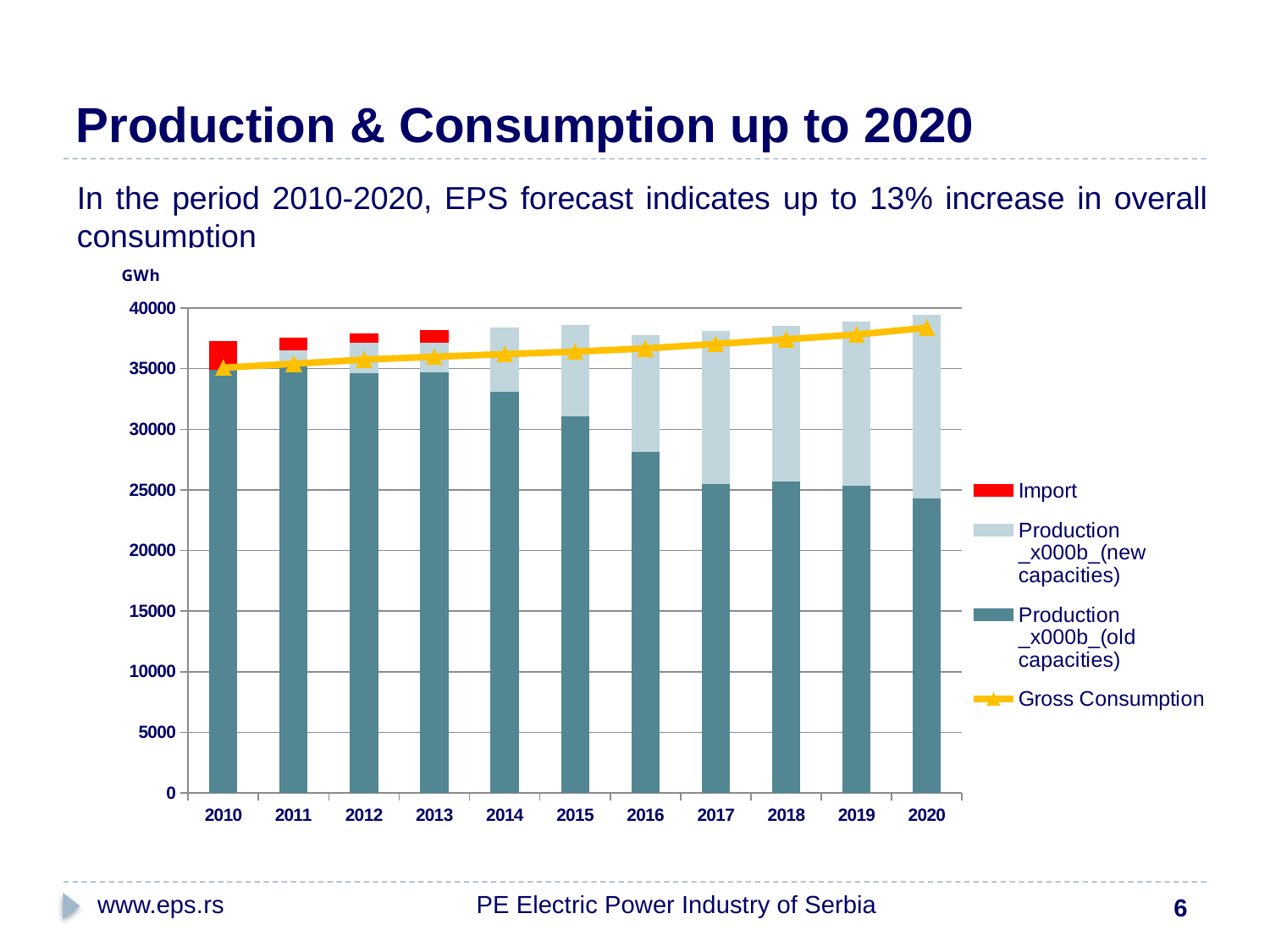
Does Production (old capacities) rise or fall from 2010 to 2020? Falls What unit is shown on the chart's vertical axis? GWh Is the Production (old capacities) value for 2010 greater or less than 30000? greater What is the title of the slide containing the chart? Production & Consumption up to 2020 Is the Gross Consumption value for 2020 greater or less than 35000? greater Which year has the lowest Production (old capacities) value? 2020 Which is larger, Production (old capacities) in 2014 or in 2016? 2014 How many series does the chart's legend list? 4 What kind of chart is shown on the slide? A stacked bar chart with a line How many years are shown on the x axis of the chart? 11 Is the Production (old capacities) value for 2020 greater or less than 30000? less Does the Gross Consumption line rise or fall from 2010 to 2020? Rises